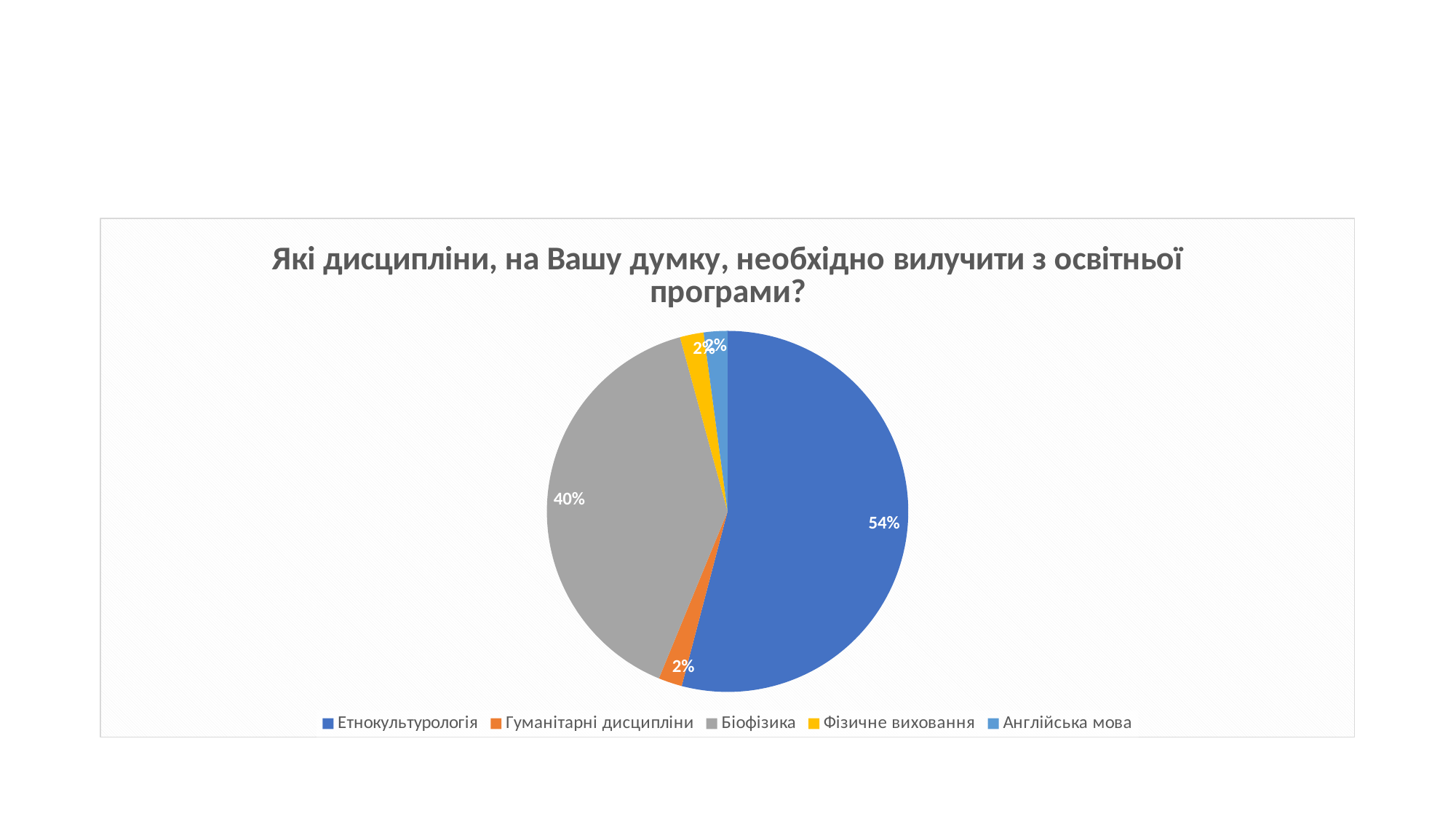
Which colour represents Біофізика in the chart? grey What is the difference between the shares of Етнокультурологія and Біофізика? 14% Which category has the largest slice of the pie? Етнокультурологія Is the share for Етнокультурологія greater or less than 50%? greater Which is larger, the share for Біофізика or the share for Гуманітарні дисципліни? Біофізика What share of the pie does Гуманітарні дисципліни have? 2% What is the combined share of Етнокультурологія and Біофізика? 94% What share of the pie does Біофізика have? 40% How many categories does the legend list? 5 What is the title of the chart? Які дисципліни, на Вашу думку, необхідно вилучити з освітньої програми? What share of the pie does Етнокультурологія have? 54% What kind of chart is shown on the slide? pie chart